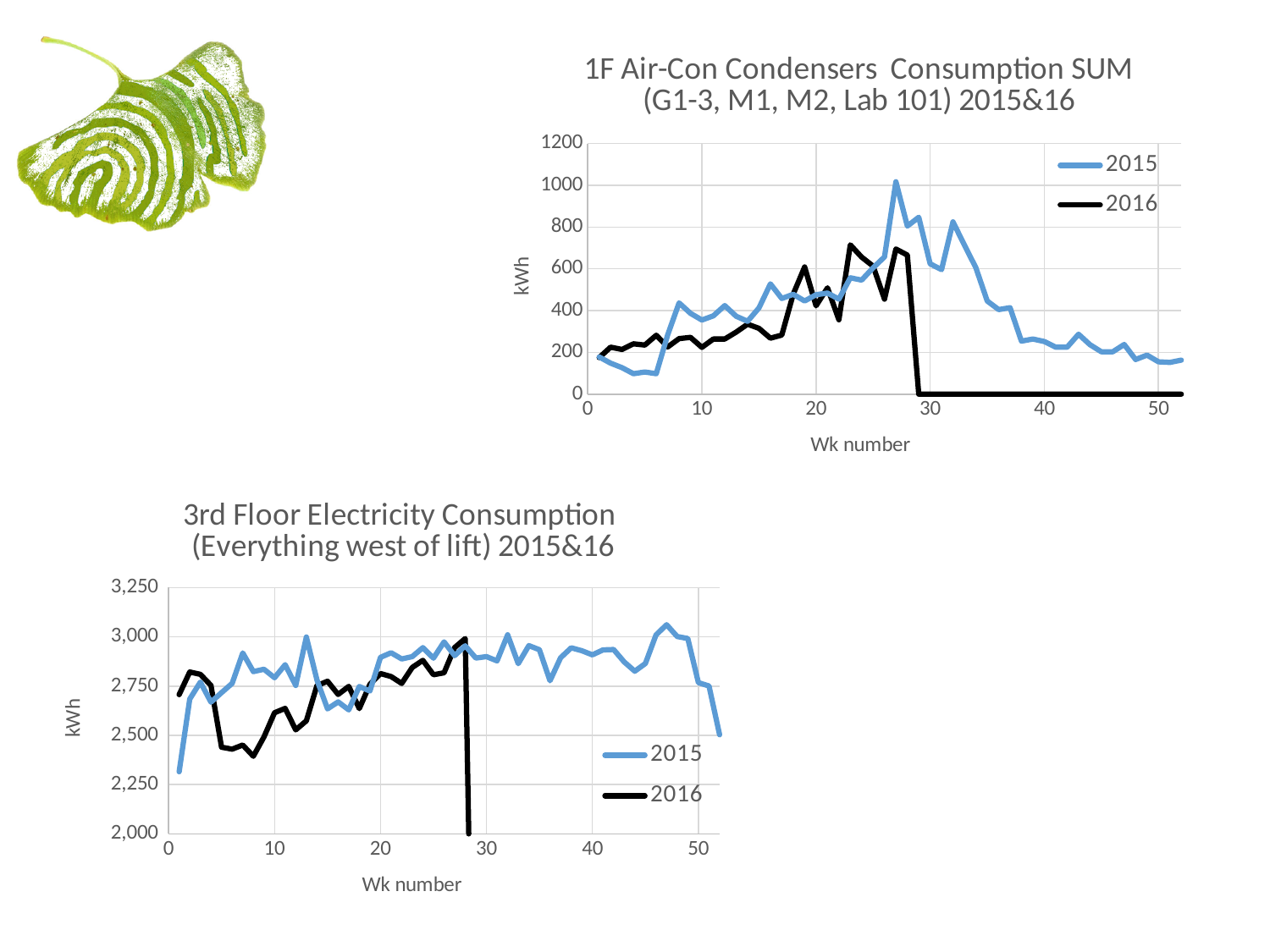
In the '3rd Floor Electricity Consumption' chart, is the highest 2015 value greater or less than 3,000? greater In the '1F Air-Con Condensers Consumption SUM' chart, which series has the higher value at week 40, 2015 or 2016? 2015 In the '1F Air-Con Condensers Consumption SUM' chart, which series is drawn in black? 2016 In the '1F Air-Con Condensers Consumption SUM' chart, does the 2015 series rise or fall between week 30 and week 50? Fall How many series does the legend of the '3rd Floor Electricity Consumption' chart list? 2 In the '3rd Floor Electricity Consumption' chart, which series has the higher value at week 7, 2015 or 2016? 2015 How many series does the legend of the '1F Air-Con Condensers Consumption SUM' chart list? 2 In the '1F Air-Con Condensers Consumption SUM' chart, is the peak value of the 2015 series greater or less than 800? greater What type of chart is the '1F Air-Con Condensers Consumption SUM' chart? Line chart What is the y-axis label of the '3rd Floor Electricity Consumption' chart? kWh In the '1F Air-Con Condensers Consumption SUM' chart, is the 2015 value at week 50 greater or less than 200? less